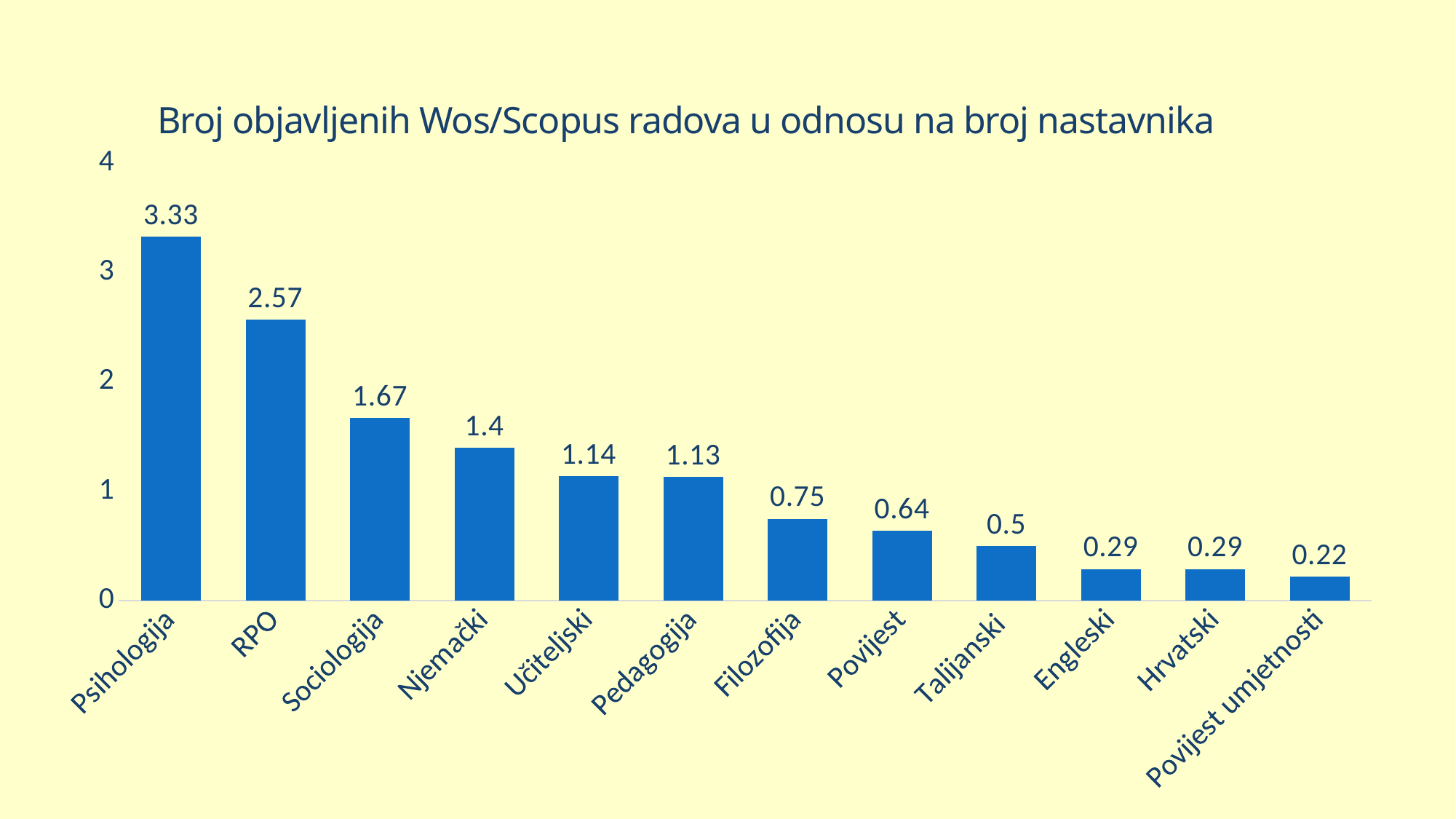
What kind of chart is shown on the slide? bar chart What is the value for Filozofija? 0.75 Do the values rise or fall from left to right along the x axis? fall What is the difference between the values for Psihologija and RPO? 0.76 Is the value for RPO greater or less than 2? greater What is the value for Njemački? 1.4 How many categories are shown on the x axis? 12 Which category has the lowest value? Povijest umjetnosti Which category has the highest value? Psihologija Which is larger, the value for Sociologija or the value for Povijest? Sociologija What is the title of the chart? Broj objavljenih Wos/Scopus radova u odnosu na broj nastavnika What is the value for Psihologija? 3.33